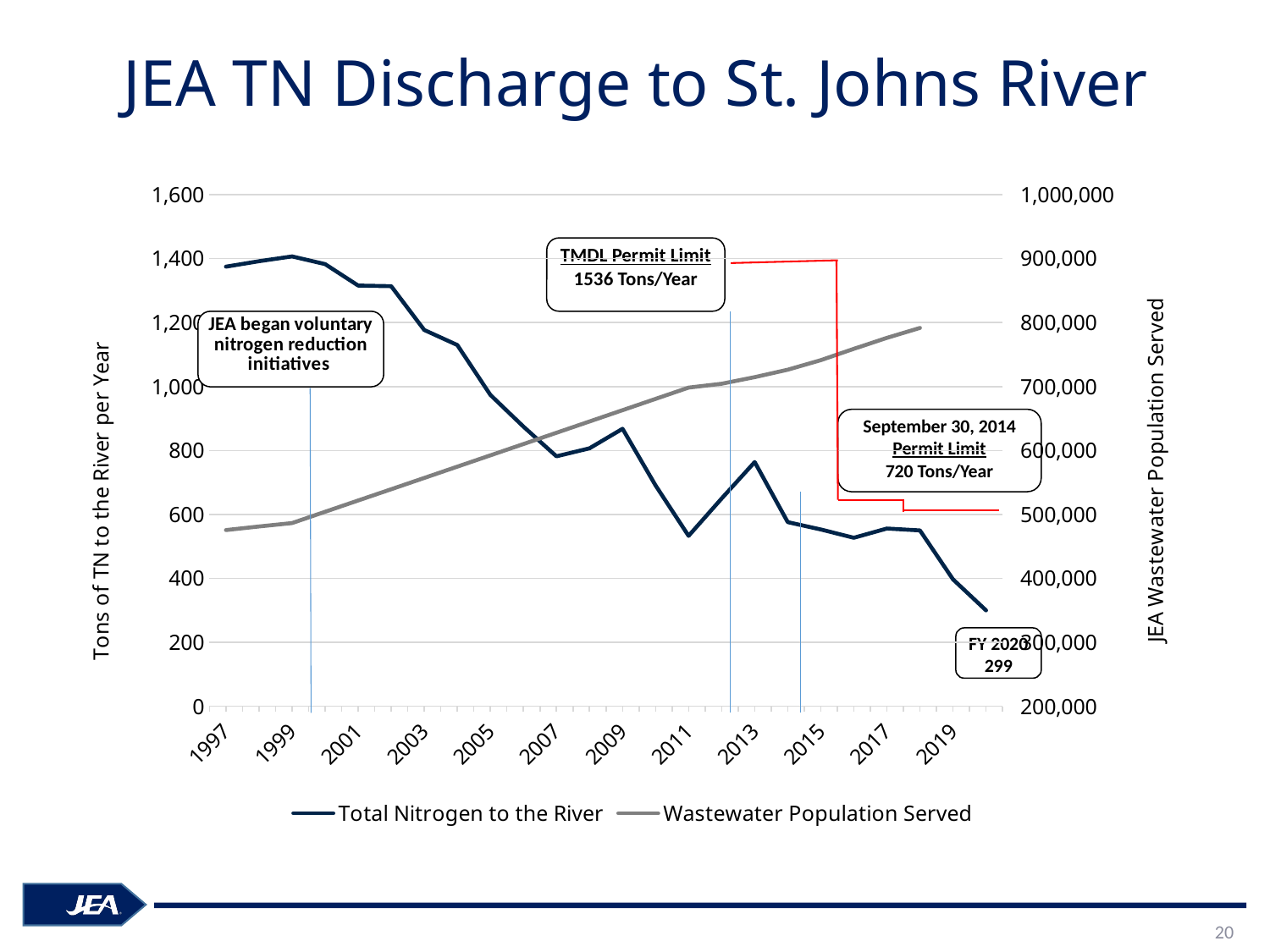
Which year has the higher Total Nitrogen to the River value, 2009 or 2011? 2009 What is the title of the chart? JEA TN Discharge to St. Johns River What permit limit in tons per year is given in the September 30, 2014 annotation? 720 Tons/Year Is the Total Nitrogen to the River value for 1997 greater or less than 1,200? greater Is the Total Nitrogen to the River value for 2011 greater or less than 600? less What is the Total Nitrogen to the River value labelled for FY 2020? 299 Does the Total Nitrogen to the River series generally rise or fall from 1997 to 2020? fall In which year does the Total Nitrogen to the River series reach its highest value? 1999 Does the Wastewater Population Served series rise or fall across the years shown? rise What kind of chart is shown on the slide? line chart How many series does the legend list? 2